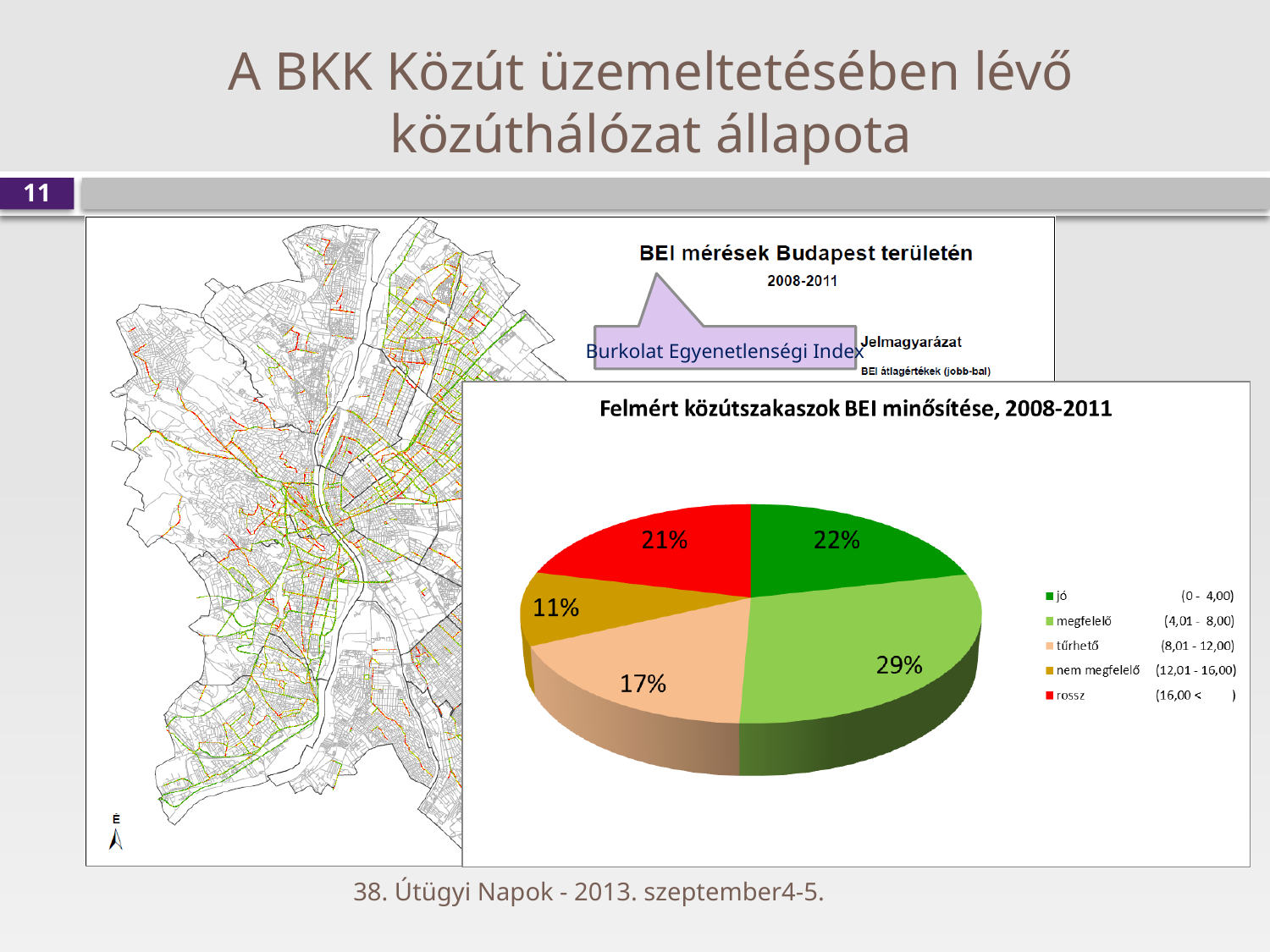
What type of chart is shown on the slide? pie chart What is the title of the pie chart? Felmért közútszakaszok BEI minősítése, 2008-2011 Which slice is larger, "jó" or "rossz"? jó What is the difference in percentage points between the "megfelelő" and "tűrhető" slices? 12 How many categories does the pie chart legend list? 5 What share of the pie chart is labelled "rossz"? 21% What share of the pie chart is labelled "megfelelő"? 29% What share of the pie chart is labelled "nem megfelelő"? 11% What share of the pie chart is labelled "tűrhető"? 17% What share of the pie chart is labelled "jó"? 22% Which category has the largest slice in the pie chart? megfelelő Which category has the smallest slice in the pie chart? nem megfelelő